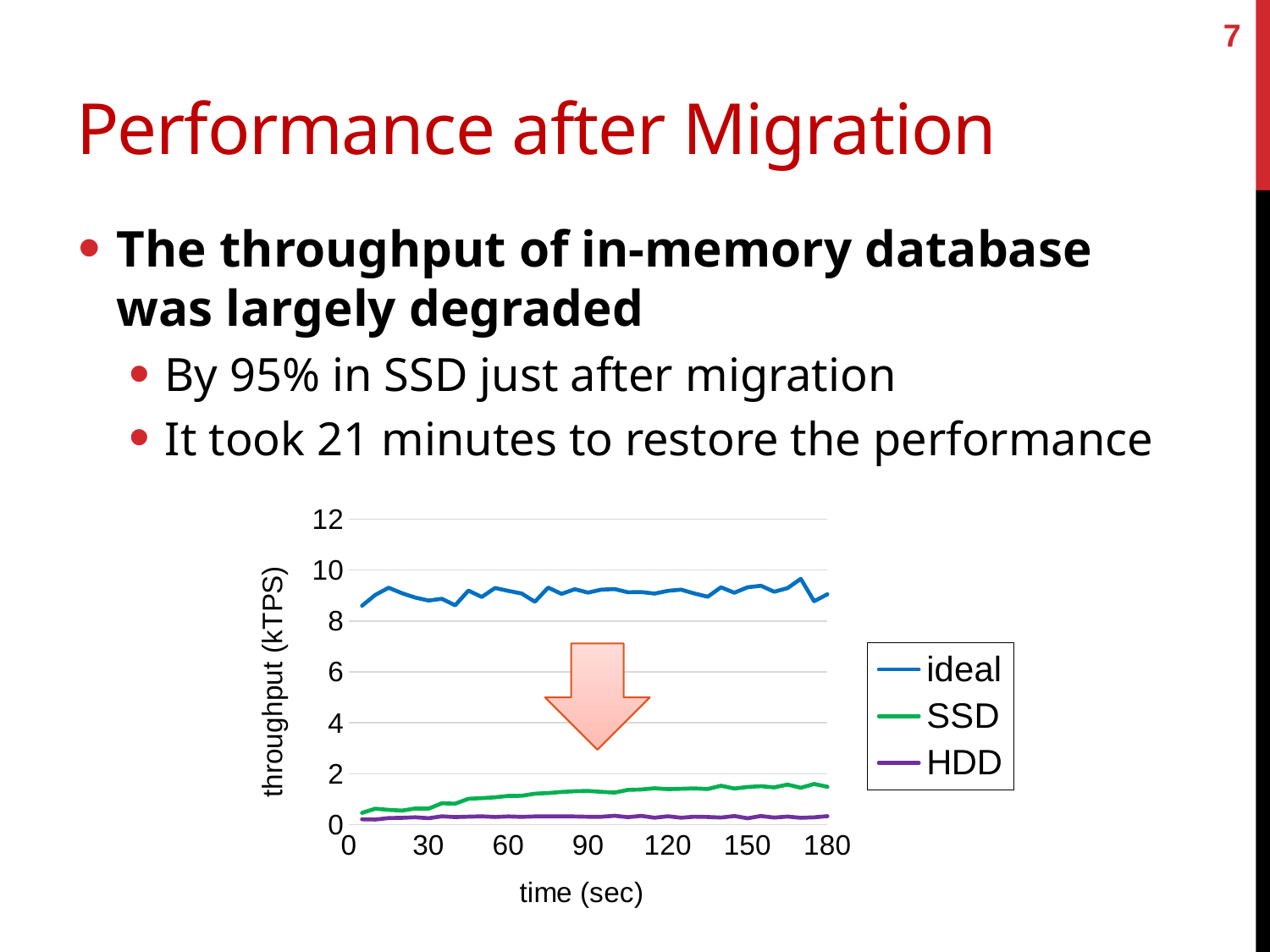
What kind of chart is shown on the slide? line chart How many series does the chart's legend list? 3 Which series has higher throughput at 120 seconds, SSD or HDD? SSD What is the label of the chart's y axis? throughput (kTPS) Is the throughput of the HDD series at 90 seconds greater or less than 2? less Is the throughput of the ideal series at 30 seconds greater or less than 10? less Which series has the highest throughput throughout the chart? ideal Does the SSD series rise or fall as time increases from 0 to 180 seconds? rise Which series has the lowest throughput throughout the chart? HDD What are the series names listed in the chart's legend? ideal, SSD, HDD Is the throughput of the SSD series at 180 seconds greater or less than 2? less